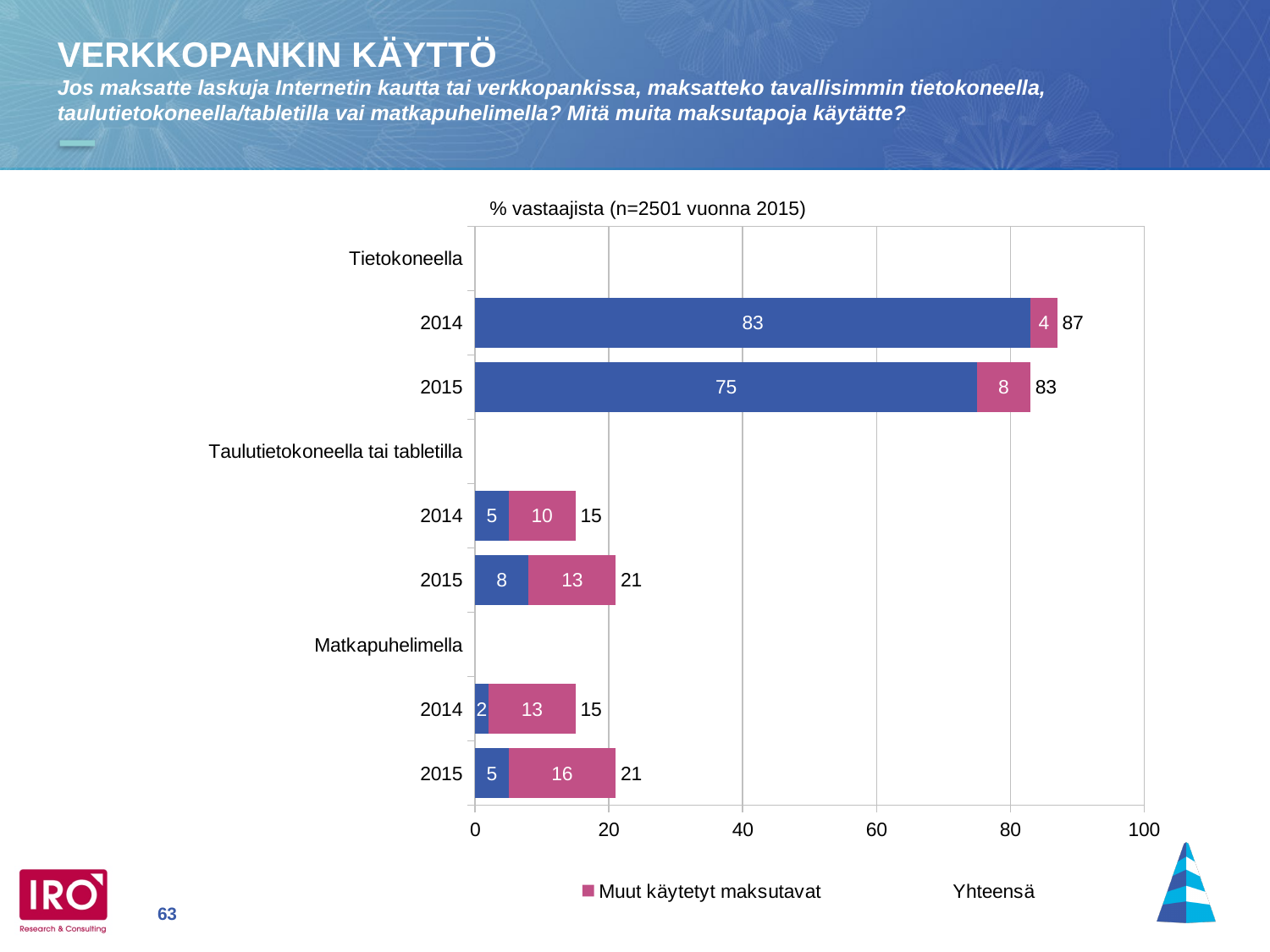
What is the value of the blue segment for Taulutietokoneella tai tabletilla in 2015? 8 What is the value of the 'Muut käytetyt maksutavat' segment for Matkapuhelimella in 2015? 16 Which bar has the highest total value? Tietokoneella 2014 What is the difference between the Tietokoneella totals for 2014 and 2015? 4 By how much did the 'Muut käytetyt maksutavat' value for Matkapuhelimella change from 2014 to 2015? 3 What kind of chart is shown on the slide? Stacked bar chart What is the total (Yhteensä) shown for Tietokoneella in 2014? 87 Is the total for Tietokoneella in 2015 greater or less than 80? greater What is the value of the 'Muut käytetyt maksutavat' segment for Tietokoneella in 2015? 8 How many stacked bars are plotted in the chart? 6 Which is larger: the 'Muut käytetyt maksutavat' value for Taulutietokoneella tai tabletilla in 2015 or for Matkapuhelimella in 2015? Matkapuhelimella 2015 What is the title of the chart? % vastaajista (n=2501 vuonna 2015)